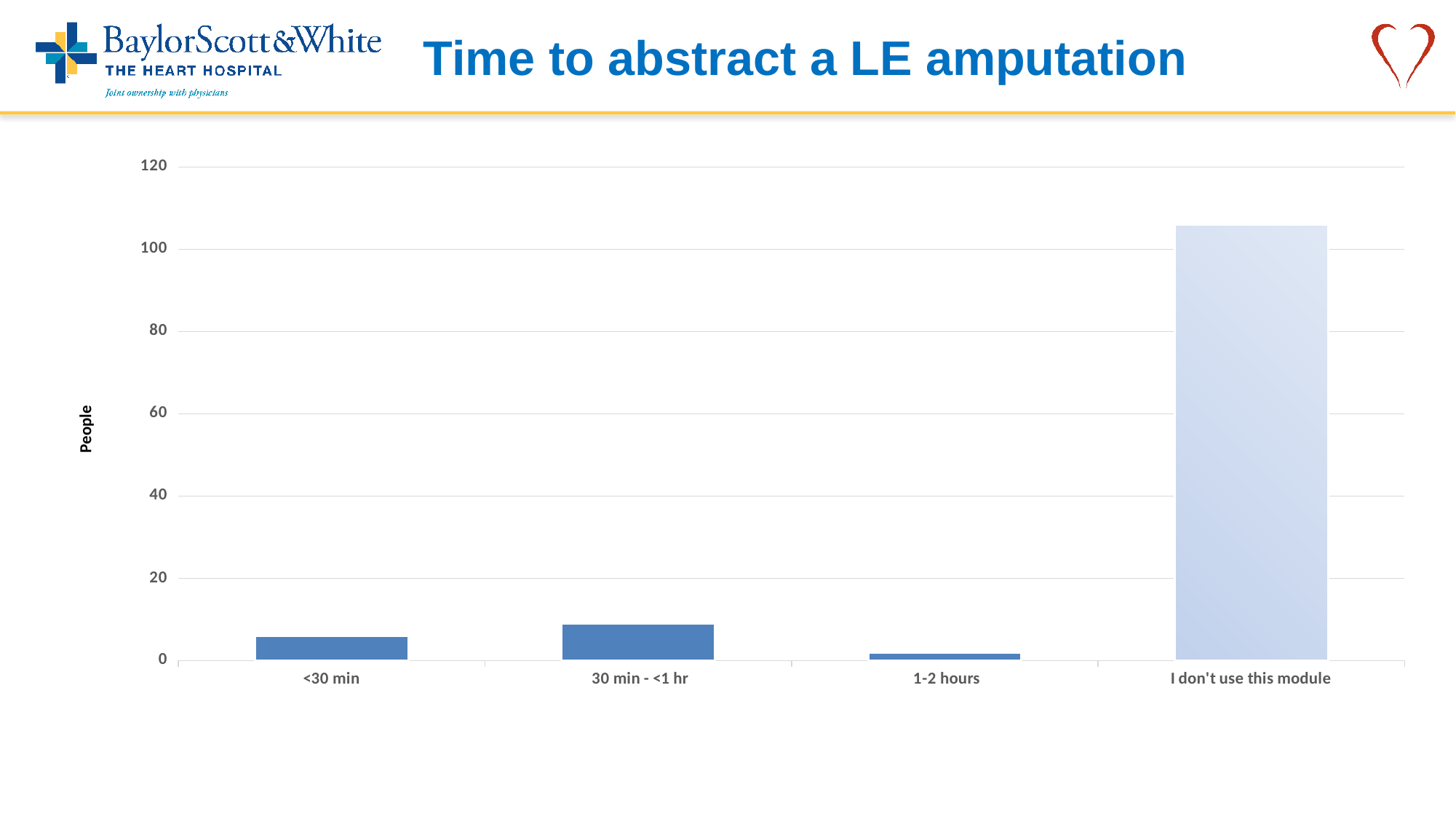
Which category has the lowest value in the chart? 1-2 hours Is the value for "I don't use this module" greater or less than 100? greater How many categories are shown on the x axis of the chart? 4 What is the label on the y axis of the chart? People What is the title of the chart on the slide? Time to abstract a LE amputation Is the value for "30 min - <1 hr" greater or less than 20? less Which is larger, the value for "30 min - <1 hr" or the value for "1-2 hours"? 30 min - <1 hr Which category has the highest value in the chart? I don't use this module Is the value for "<30 min" greater or less than 20? less What kind of chart is shown on the slide? bar chart Which is larger, the value for "<30 min" or the value for "I don't use this module"? I don't use this module